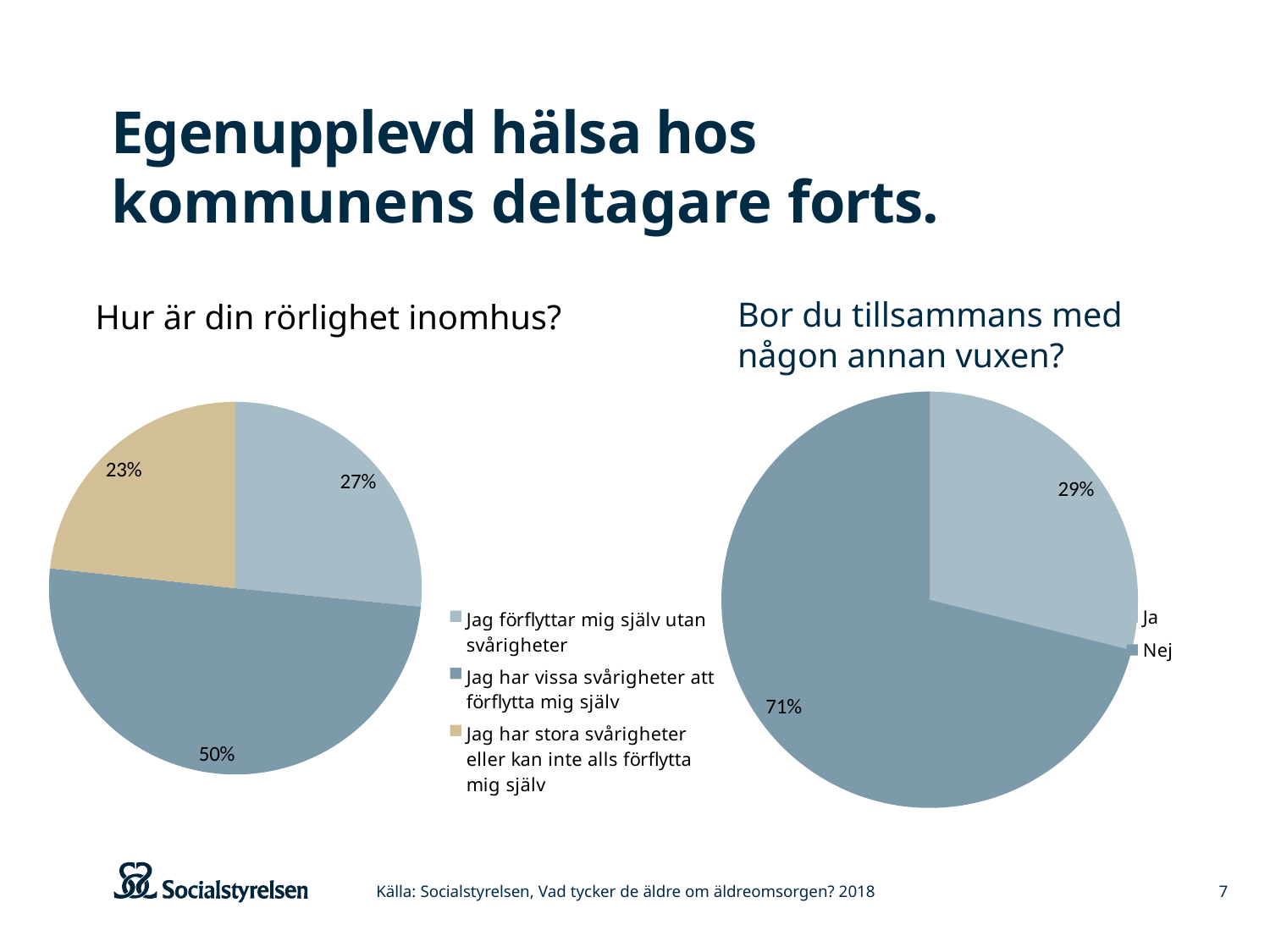
In the 'Hur är din rörlighet inomhus?' chart, what is the difference in percentage points between the 50% slice and the 23% slice? 27 percentage points In the 'Hur är din rörlighet inomhus?' chart, what share is labelled for 'Jag har stora svårigheter eller kan inte alls förflytta mig själv'? 23% In the 'Hur är din rörlighet inomhus?' chart, which category has the largest slice? Jag har vissa svårigheter att förflytta mig själv In the 'Hur är din rörlighet inomhus?' chart, which category has the smallest slice? Jag har stora svårigheter eller kan inte alls förflytta mig själv In the 'Hur är din rörlighet inomhus?' chart, what share is labelled for 'Jag förflyttar mig själv utan svårigheter'? 27% In the 'Bor du tillsammans med någon annan vuxen?' chart, what share answered 'Ja'? 29% In the 'Bor du tillsammans med någon annan vuxen?' chart, what share answered 'Nej'? 71% In the 'Bor du tillsammans med någon annan vuxen?' chart, which answer has the larger slice, 'Ja' or 'Nej'? Nej What type of chart is used for 'Bor du tillsammans med någon annan vuxen?'? Pie chart In the 'Hur är din rörlighet inomhus?' chart, how many slices does the pie have? 3 In the 'Bor du tillsammans med någon annan vuxen?' chart, what is the difference in percentage points between 'Nej' and 'Ja'? 42 percentage points In the 'Hur är din rörlighet inomhus?' chart, what share is labelled for 'Jag har vissa svårigheter att förflytta mig själv'? 50%